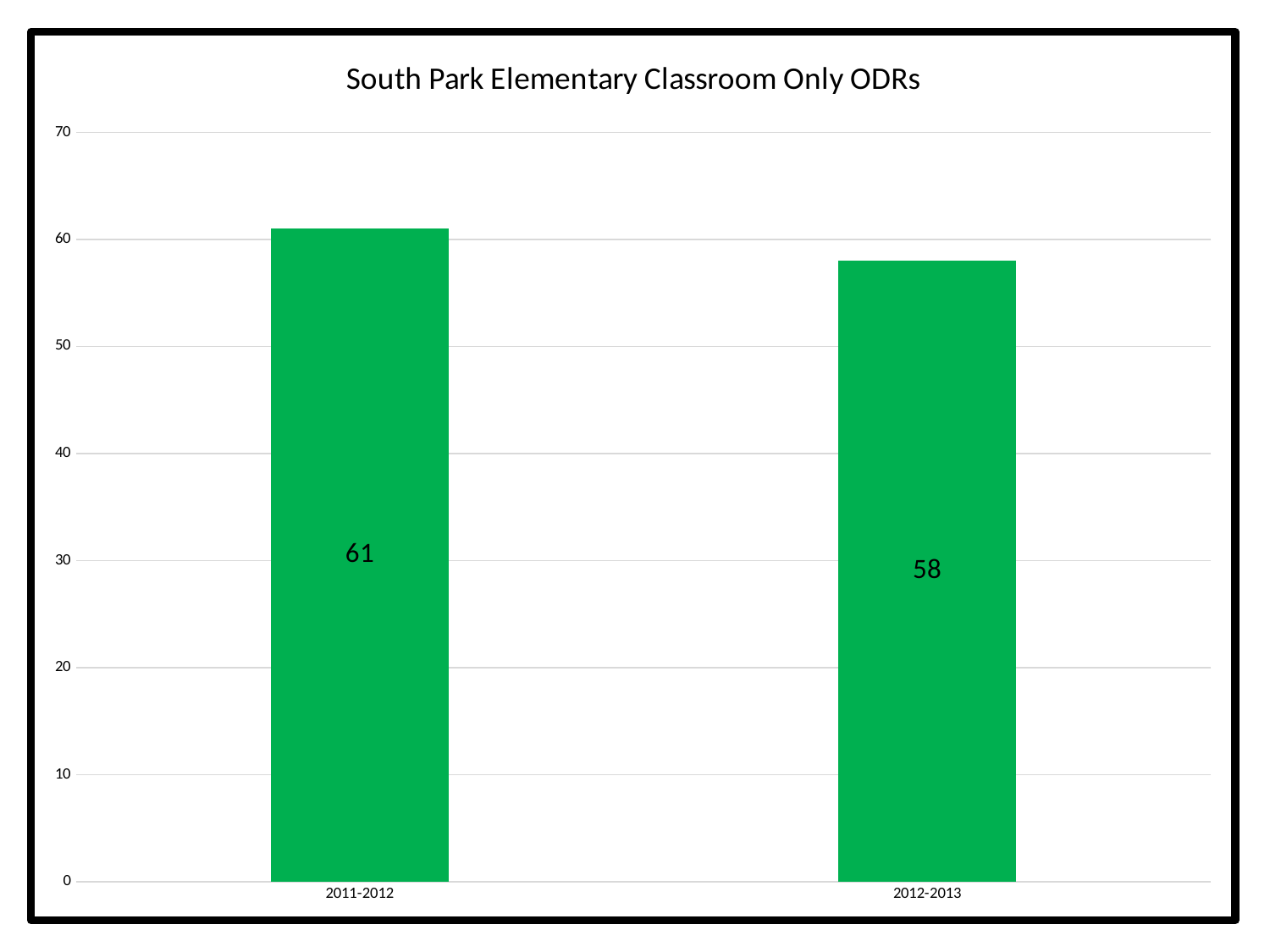
What is the value for 2012-2013? 58 What is the difference between the values for 2011-2012 and 2012-2013? 3 Which year has the lowest value? 2012-2013 Which year has the highest value? 2011-2012 What is the title of the chart? South Park Elementary Classroom Only ODRs Do the values rise or fall from 2011-2012 to 2012-2013? fall Is the value for 2012-2013 greater or less than 60? less What kind of chart is shown on the slide? bar chart How many categories are shown on the x axis? 2 What is the value for 2011-2012? 61 Which is larger, the value for 2011-2012 or the value for 2012-2013? 2011-2012 Is the value for 2011-2012 greater or less than 60? greater